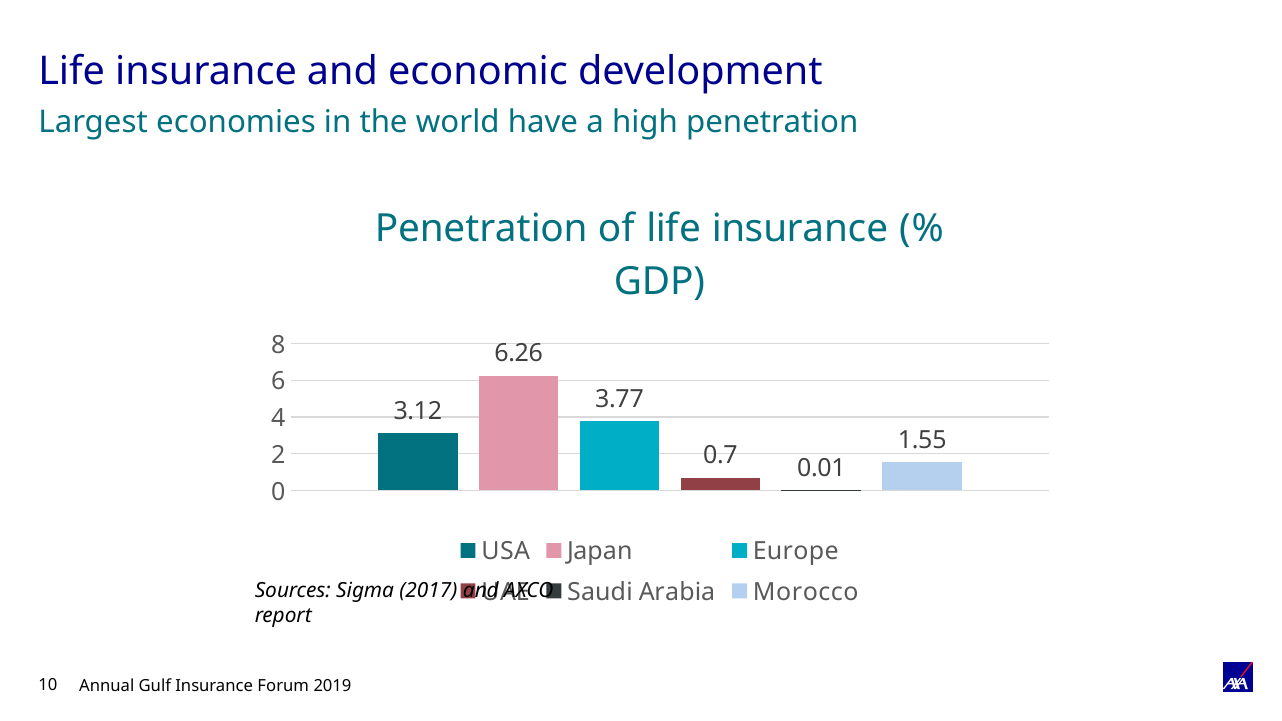
Which country or region has the highest penetration of life insurance? Japan Is the value for Morocco greater or less than 2? less What is the penetration of life insurance (% GDP) for Japan? 6.26 What is the difference between Japan's and the USA's life insurance penetration? 3.14 What type of chart is shown on the slide? Bar chart Which has a higher life insurance penetration, Europe or the USA? Europe What is the penetration of life insurance (% GDP) for Saudi Arabia? 0.01 Which country or region has the lowest penetration of life insurance? Saudi Arabia What is the penetration of life insurance (% GDP) for the USA? 3.12 What is the penetration of life insurance (% GDP) for Europe? 3.77 How many bars are plotted in the chart? 6 What is the penetration of life insurance (% GDP) for Morocco? 1.55